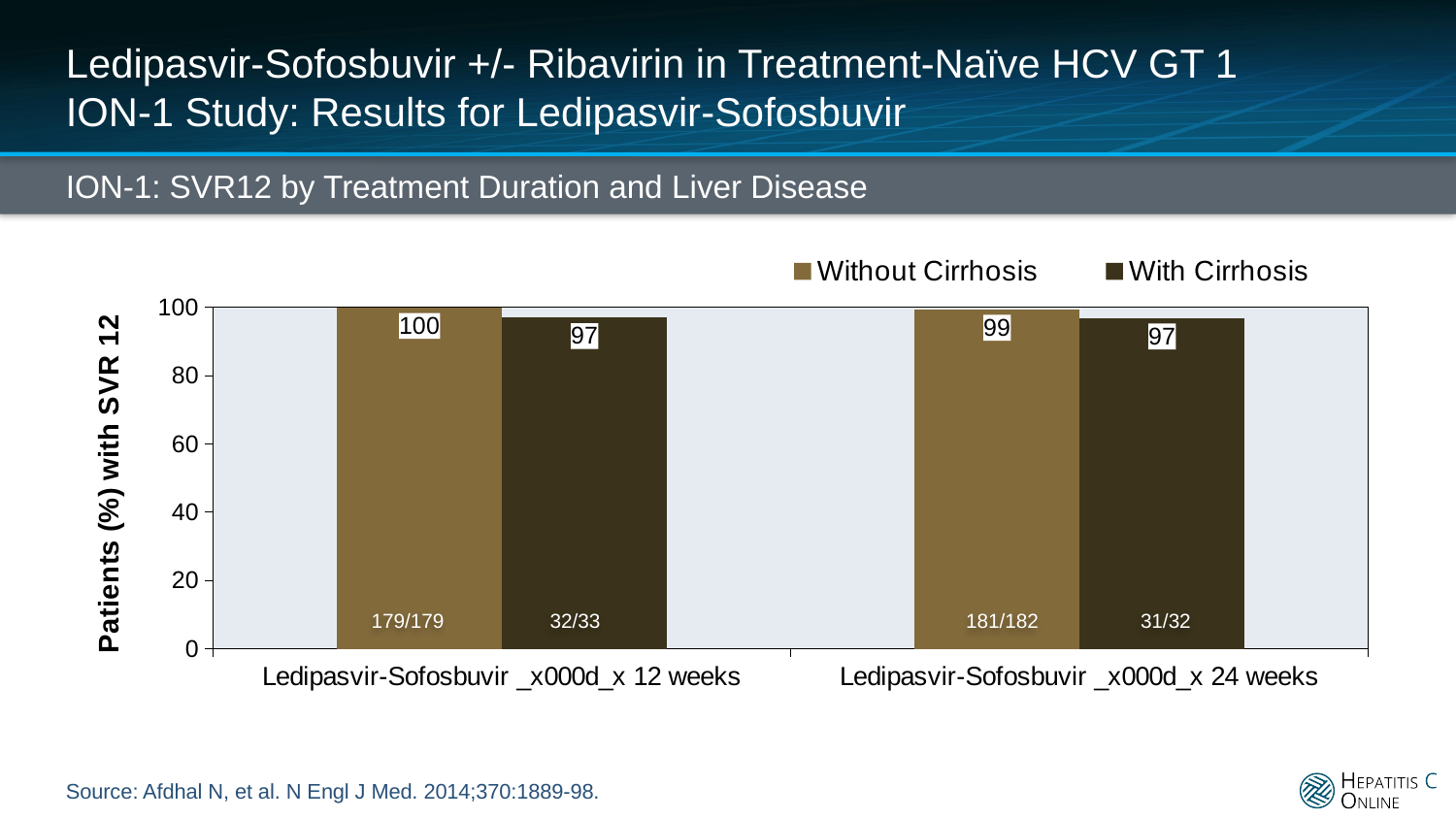
Which bar has the highest SVR12 value? Without Cirrhosis, Ledipasvir-Sofosbuvir 12 weeks What is the label of the y-axis? Patients (%) with SVR 12 What is the SVR12 rate for patients with cirrhosis treated with Ledipasvir-Sofosbuvir for 24 weeks? 97 How many series does the legend list? 2 Which is larger: the SVR12 for patients without cirrhosis at 24 weeks or with cirrhosis at 24 weeks? Without Cirrhosis What is the difference in SVR12 between patients without cirrhosis in the 12-week group and the 24-week group? 1 What kind of chart is shown on the slide? Bar chart What fraction of patients is shown inside the bar for patients without cirrhosis treated for 24 weeks? 181/182 What is the difference in SVR12 between patients without cirrhosis and with cirrhosis in the 12-week group? 3 What fraction of patients is shown inside the bar for patients with cirrhosis treated for 12 weeks? 32/33 What is the SVR12 rate for patients without cirrhosis treated with Ledipasvir-Sofosbuvir for 24 weeks? 99 What is the SVR12 rate for patients without cirrhosis treated with Ledipasvir-Sofosbuvir for 12 weeks? 100